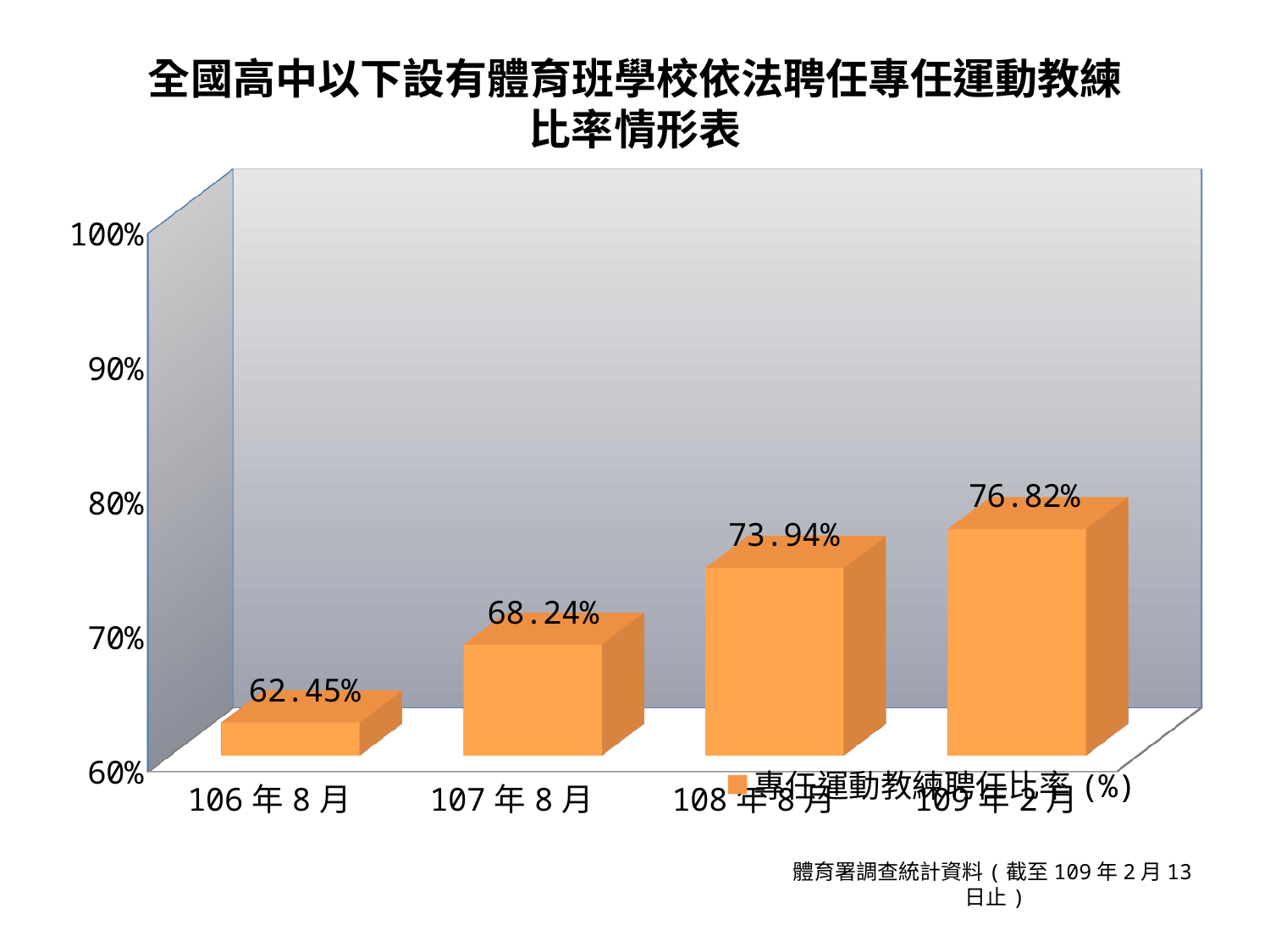
Which category has the lowest value? 106年8月 What is the value for 107年8月? 68.24% What is the value for 109年2月? 76.82% How many categories are shown on the x axis? 4 What is the difference between the values for 109年2月 and 106年8月? 14.37% Which is larger, the value for 107年8月 or the value for 108年8月? 108年8月 What is the value for 106年8月? 62.45% What is the value for 108年8月? 73.94% Do the values rise or fall from 106年8月 to 109年2月? rise What kind of chart is this? bar chart Is the value for 109年2月 greater or less than 80%? less Which category has the highest value? 109年2月